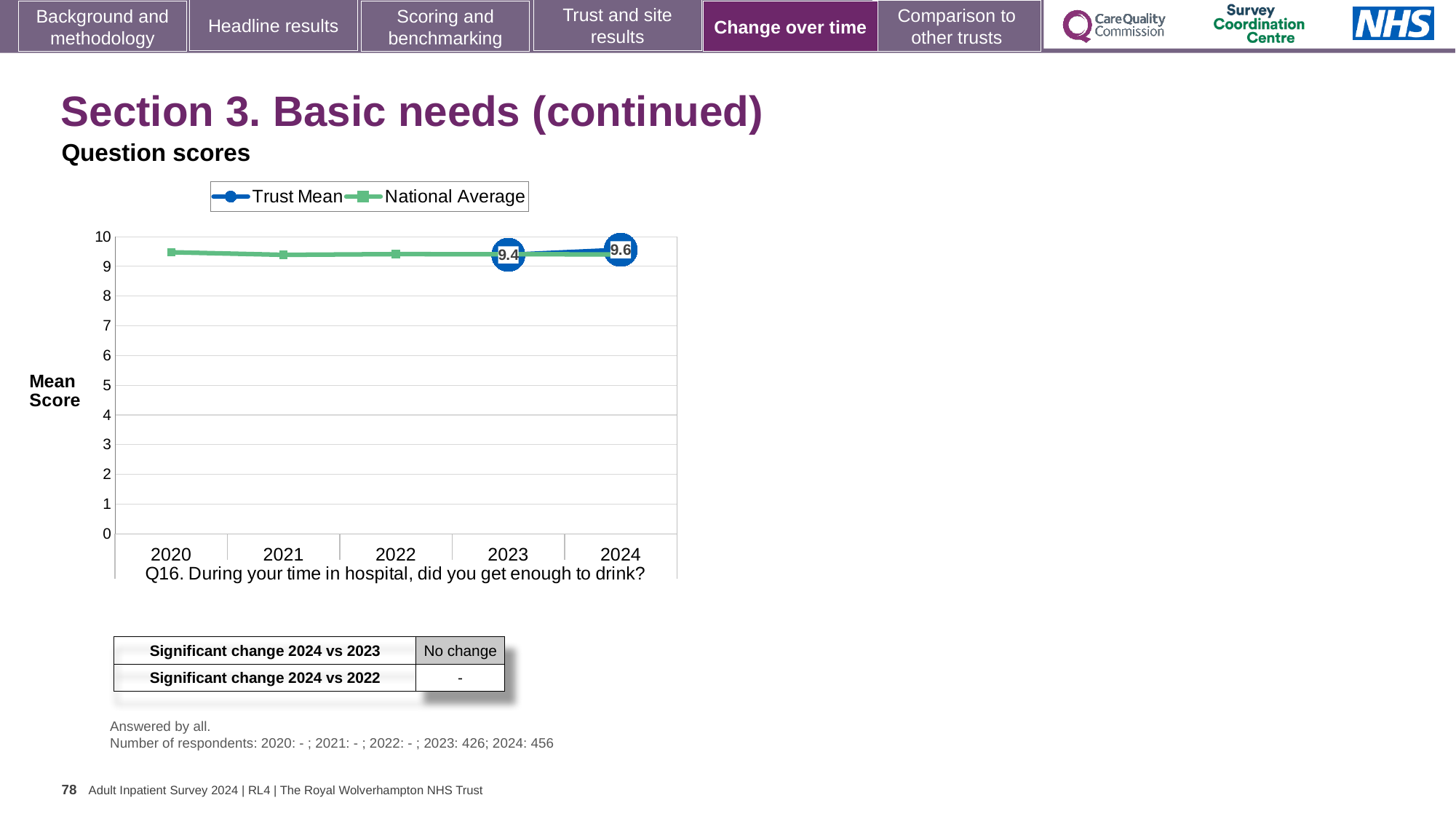
Does the Trust Mean rise or fall from 2023 to 2024? rise What is the Trust Mean score for 2023? 9.4 Is the National Average value for 2022 greater or less than 8? greater How many years are shown on the x axis of the chart? 5 What kind of chart is shown on the slide? line chart Is the National Average value for 2020 greater or less than 9? greater How many series does the chart legend list? 2 Which year has the higher Trust Mean, 2023 or 2024? 2024 Which survey question does the chart show scores for? Q16. During your time in hospital, did you get enough to drink? What are the two series named in the chart legend? Trust Mean and National Average By how much did the Trust Mean change from 2023 to 2024? 0.2 What is the Trust Mean score for 2024? 9.6